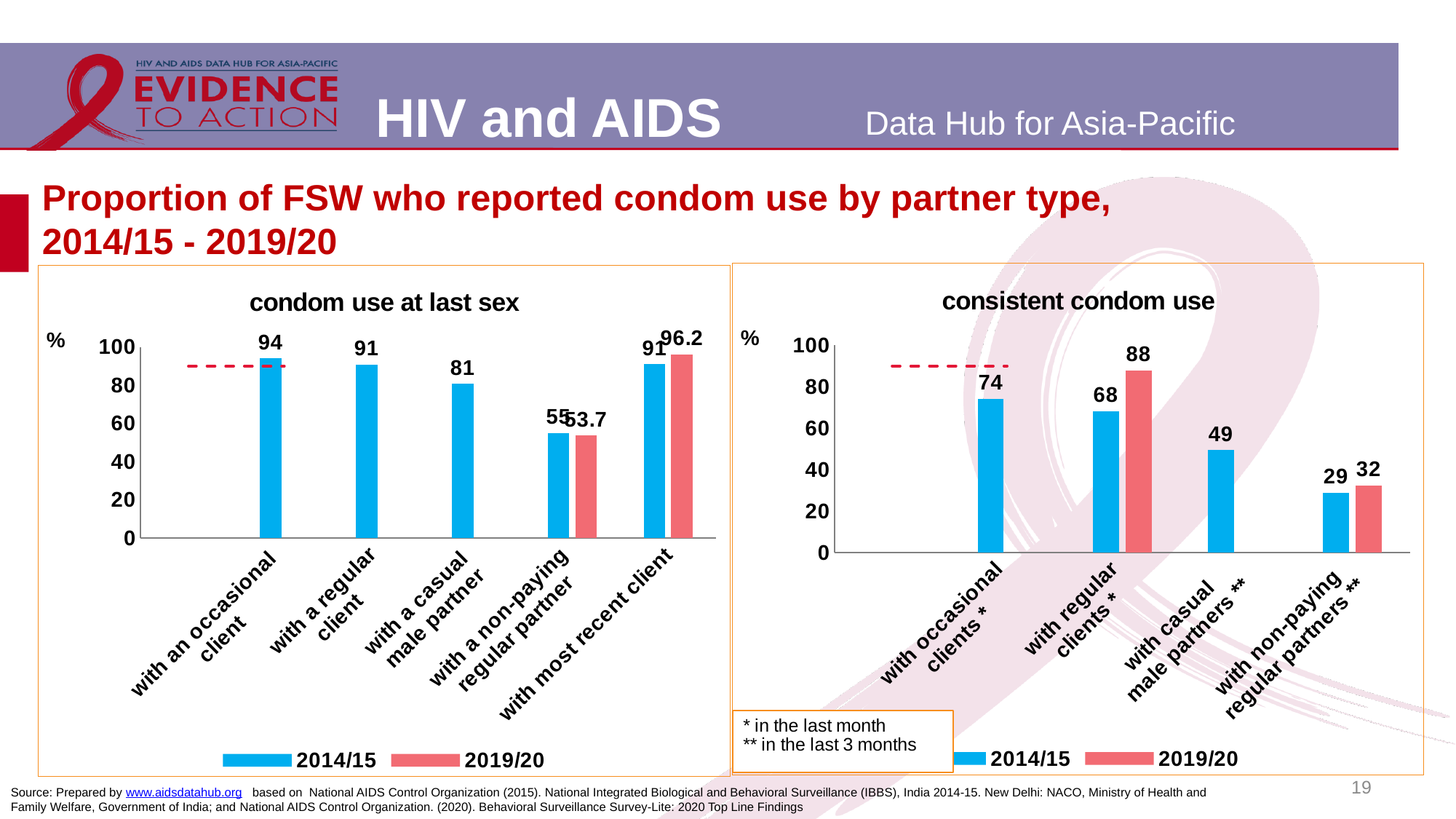
What type of chart is the 'condom use at last sex' chart? bar chart In the 'consistent condom use' chart, what is the 2014/15 value for consistent condom use with casual male partners? 49 In the 'consistent condom use' chart, what is the difference between the 2019/20 and 2014/15 values for consistent condom use with regular clients? 20 In the 'consistent condom use' chart, which category has the highest 2014/15 value? with occasional clients In the 'consistent condom use' chart, what is the 2019/20 value for consistent condom use with regular clients? 88 In the 'condom use at last sex' chart, which category has the lowest 2014/15 value? with a non-paying regular partner In the 'condom use at last sex' chart, what is the 2014/15 value for condom use with an occasional client? 94 In the 'consistent condom use' chart, is the 2014/15 value for non-paying regular partners larger or smaller than the 2019/20 value? smaller In the 'condom use at last sex' chart, how many partner-type categories are shown on the x axis? 5 In the 'condom use at last sex' chart, what is the difference between the 2014/15 and 2019/20 values for condom use with a non-paying regular partner? 1.3 How many series does the legend of the 'consistent condom use' chart list? 2 In the 'condom use at last sex' chart, what is the 2019/20 value for condom use with most recent client? 96.2